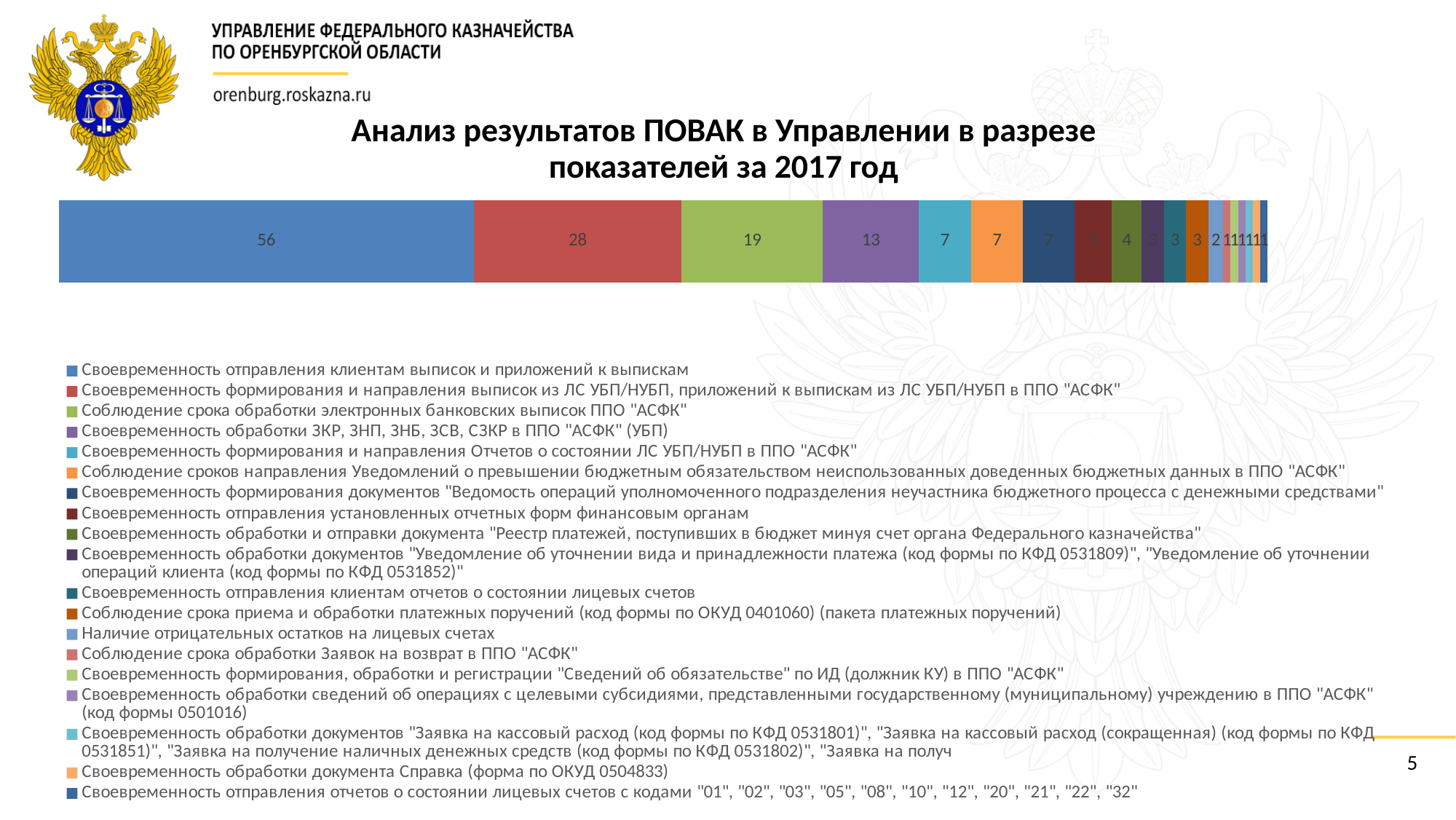
Which is larger: the value for "Соблюдение срока обработки электронных банковских выписок ППО "АСФК"" or the value for "Своевременность обработки ЗКР, ЗНП, ЗНБ, ЗСВ, СЗКР в ППО "АСФК" (УБП)"? Соблюдение срока обработки электронных банковских выписок ППО "АСФК" What is the difference between the value for "Своевременность отправления клиентам выписок и приложений к выпискам" and the value for "Своевременность формирования и направления выписок из ЛС УБП/НУБП, приложений к выпискам из ЛС УБП/НУБП в ППО "АСФК""? 28 How many series does the legend list? 19 What is the value for "Своевременность обработки ЗКР, ЗНП, ЗНБ, ЗСВ, СЗКР в ППО "АСФК" (УБП)"? 13 What is the value for "Соблюдение срока обработки электронных банковских выписок ППО "АСФК""? 19 What is the title of the chart on the slide? Анализ результатов ПОВАК в Управлении в разрезе показателей за 2017 год What is the value for "Своевременность формирования и направления Отчетов о состоянии ЛС УБП/НУБП в ППО "АСФК""? 7 What is the value for "Наличие отрицательных остатков на лицевых счетах"? 2 What kind of chart is shown on the slide? stacked bar chart Which series has the highest value in the chart? Своевременность отправления клиентам выписок и приложений к выпискам What is the value for "Своевременность отправления клиентам выписок и приложений к выпискам"? 56 What is the total of all segments in the stacked bar? 163